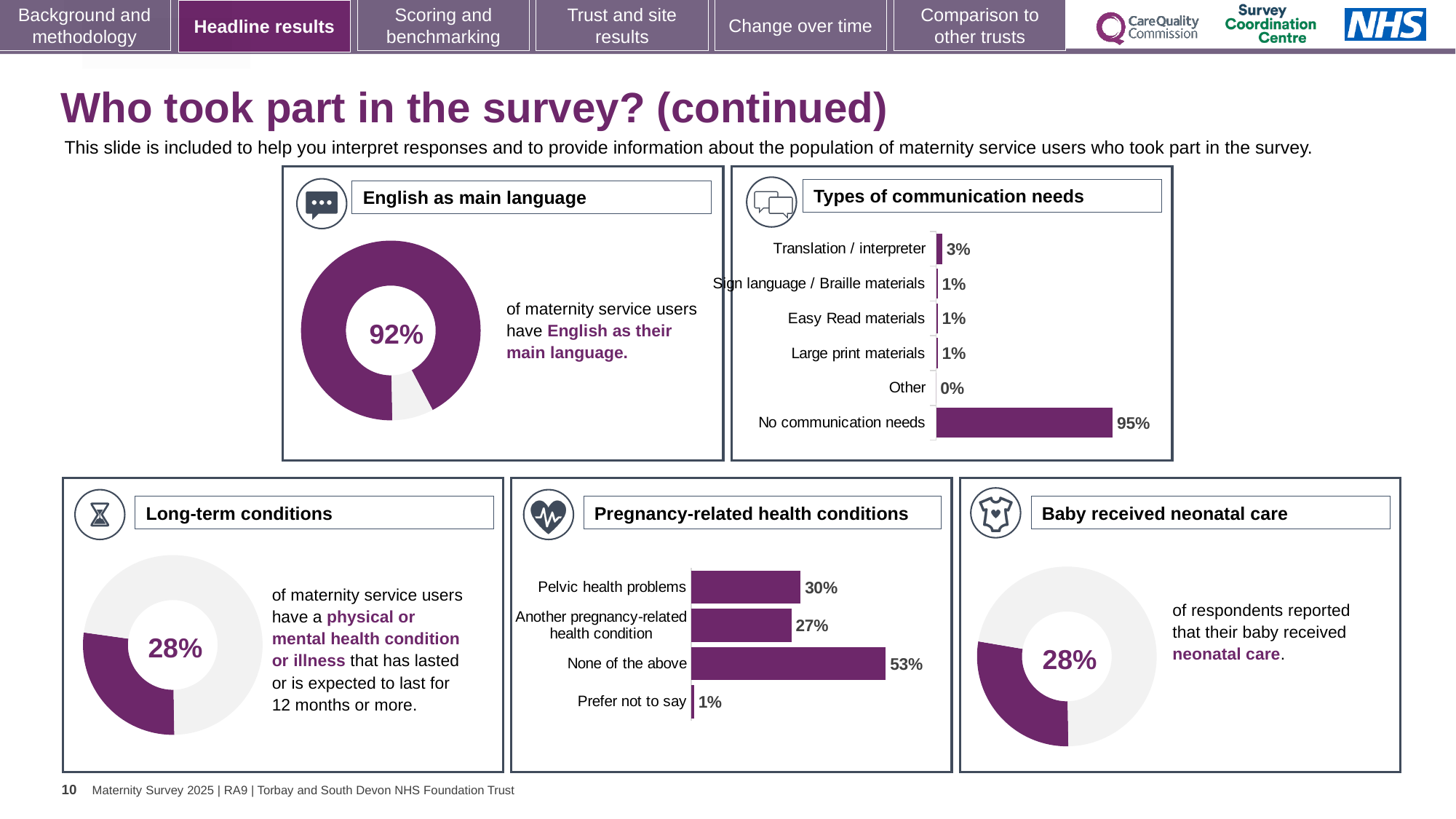
In the 'Pregnancy-related health conditions' chart, what is the difference between 'None of the above' and 'Another pregnancy-related health condition'? 26% In the 'Long-term conditions' chart, what percentage of maternity service users have a physical or mental health condition or illness? 28% In the 'Types of communication needs' chart, which category has the highest value? No communication needs In the 'Types of communication needs' chart, what percentage of maternity service users reported no communication needs? 95% In the 'Pregnancy-related health conditions' chart, which is larger: Pelvic health problems or Another pregnancy-related health condition? Pelvic health problems In the 'Pregnancy-related health conditions' chart, what is the value for Pelvic health problems? 30% In the 'Types of communication needs' chart, which category has the lowest value? Other In the 'English as main language' chart, what percentage of maternity service users have English as their main language? 92% What kind of chart is used in the 'Baby received neonatal care' panel? Donut chart What kind of chart is used in the 'Pregnancy-related health conditions' panel? Bar chart How many categories are shown in the 'Types of communication needs' chart? 6 In the 'Types of communication needs' chart, what is the value for Translation / interpreter? 3%